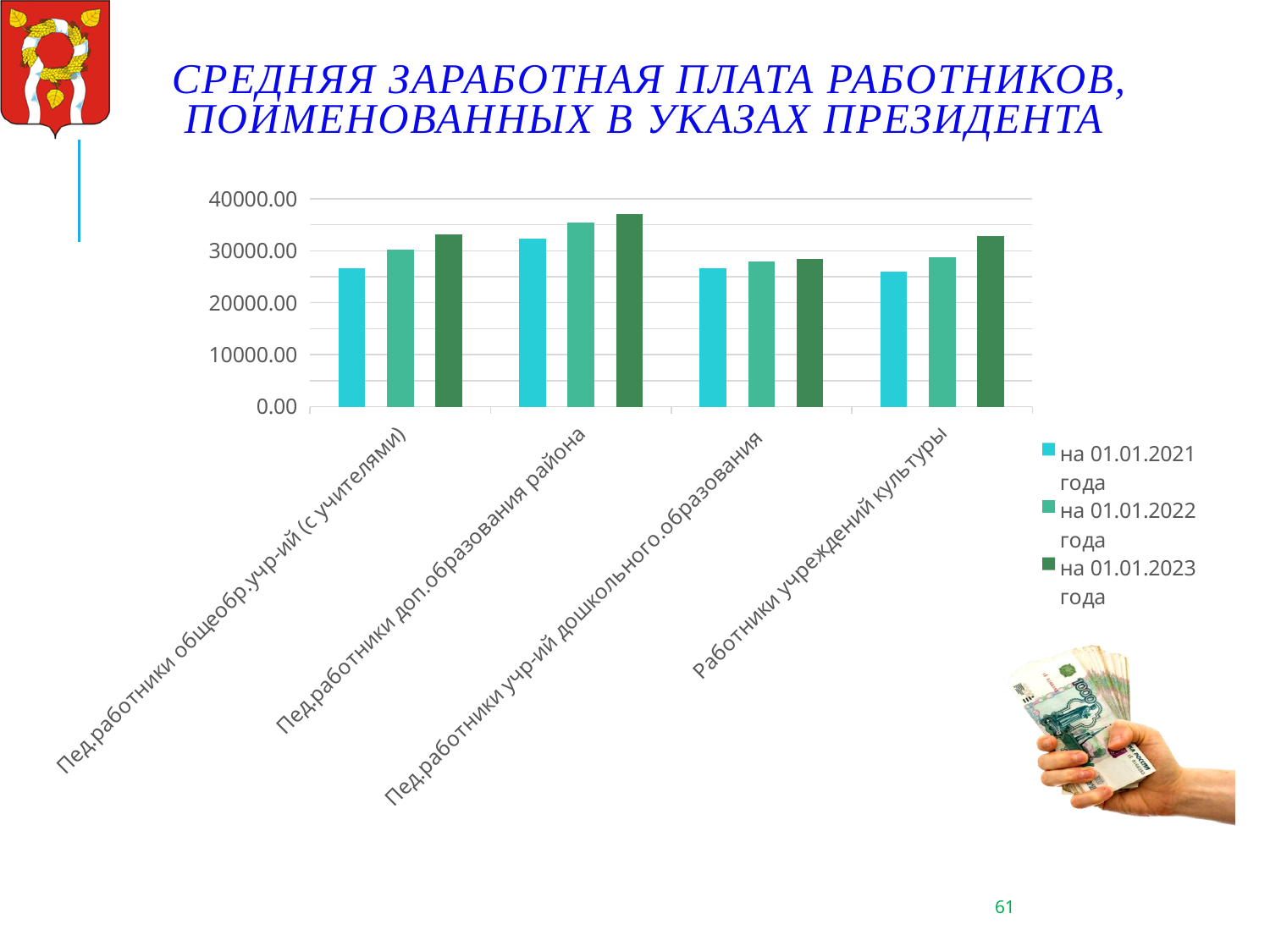
How many categories of workers are shown on the x axis? 4 Which category has the lowest bar for "на 01.01.2023 года"? Пед.работники учр-ий дошкольного.образования On 01.01.2022, which is larger: the value for "Пед.работники доп.образования района" or for "Пед.работники общеобр.учр-ий (с учителями)"? Пед.работники доп.образования района What kind of chart is shown on the slide? bar chart Is the value for "Пед.работники доп.образования района" on 01.01.2021 greater or less than 30000.00? greater Is the value for "Пед.работники общеобр.учр-ий (с учителями)" on 01.01.2021 greater or less than 30000.00? less Which category has the highest bar for "на 01.01.2023 года"? Пед.работники доп.образования района Is the value for "Работники учреждений культуры" on 01.01.2023 greater or less than 30000.00? greater For "Пед.работники общеобр.учр-ий (с учителями)", do the values rise or fall from 01.01.2021 to 01.01.2023? rise What is the first entry listed in the legend? на 01.01.2021 года How many series does the legend list? 3